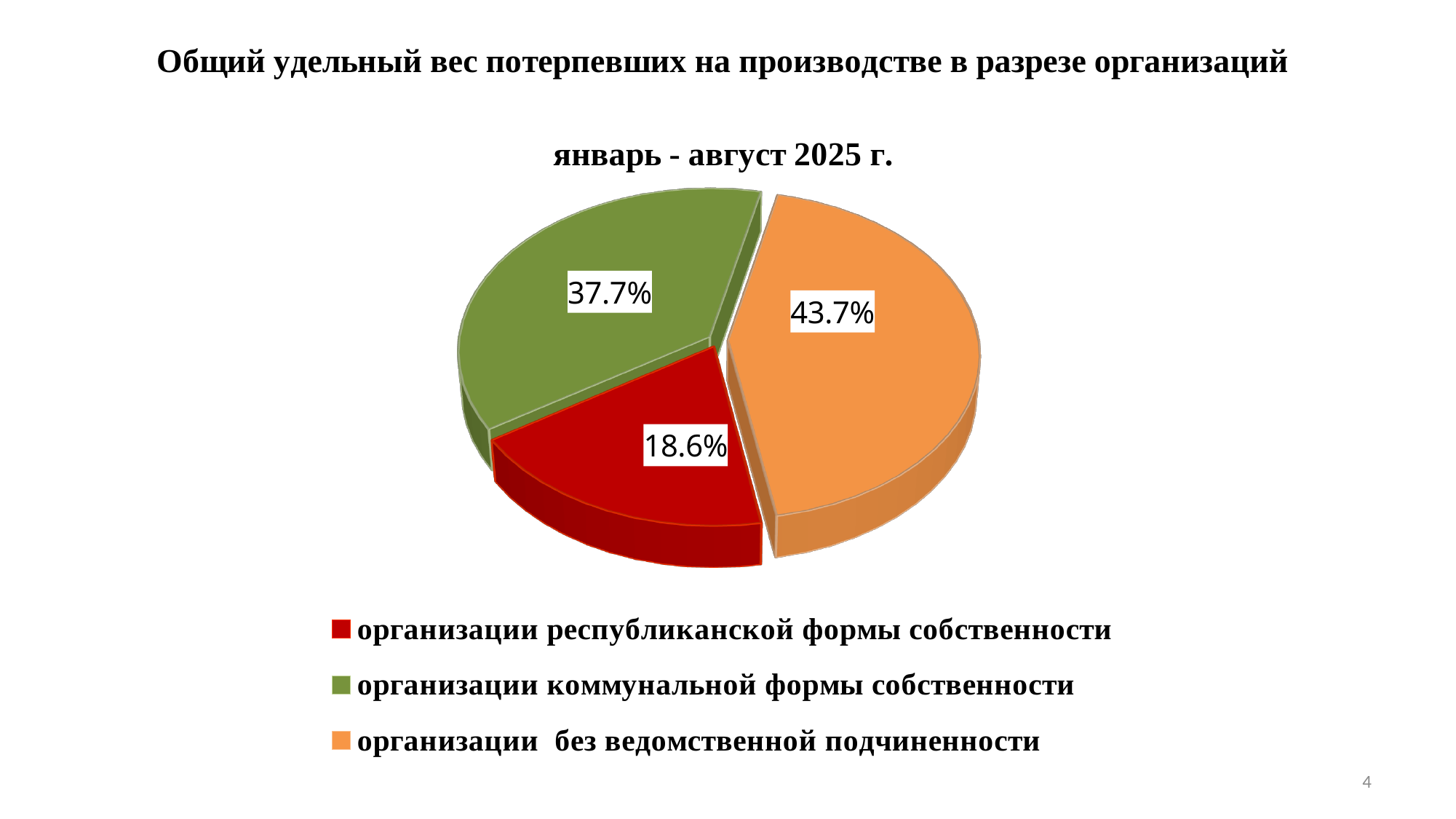
What kind of chart is shown on the slide? pie chart What is the difference in percentage points between the share for организации коммунальной формы собственности and the share for организации республиканской формы собственности? 19.1 Which is larger: the share for организации коммунальной формы собственности or the share for организации республиканской формы собственности? организации коммунальной формы собственности Which category has the largest share of the pie? организации без ведомственной подчиненности What colour is the slice for организации республиканской формы собственности? red What share of the pie is held by организации коммунальной формы собственности? 37.7% What period does the chart cover, according to its subtitle? январь - август 2025 г. How many slices does the pie chart have? 3 What share of the pie is held by организации республиканской формы собственности? 18.6% What is the difference in percentage points between the share for организации без ведомственной подчиненности and the share for организации коммунальной формы собственности? 6.0 Which category has the smallest share of the pie? организации республиканской формы собственности What share of the pie is held by организации без ведомственной подчиненности? 43.7%